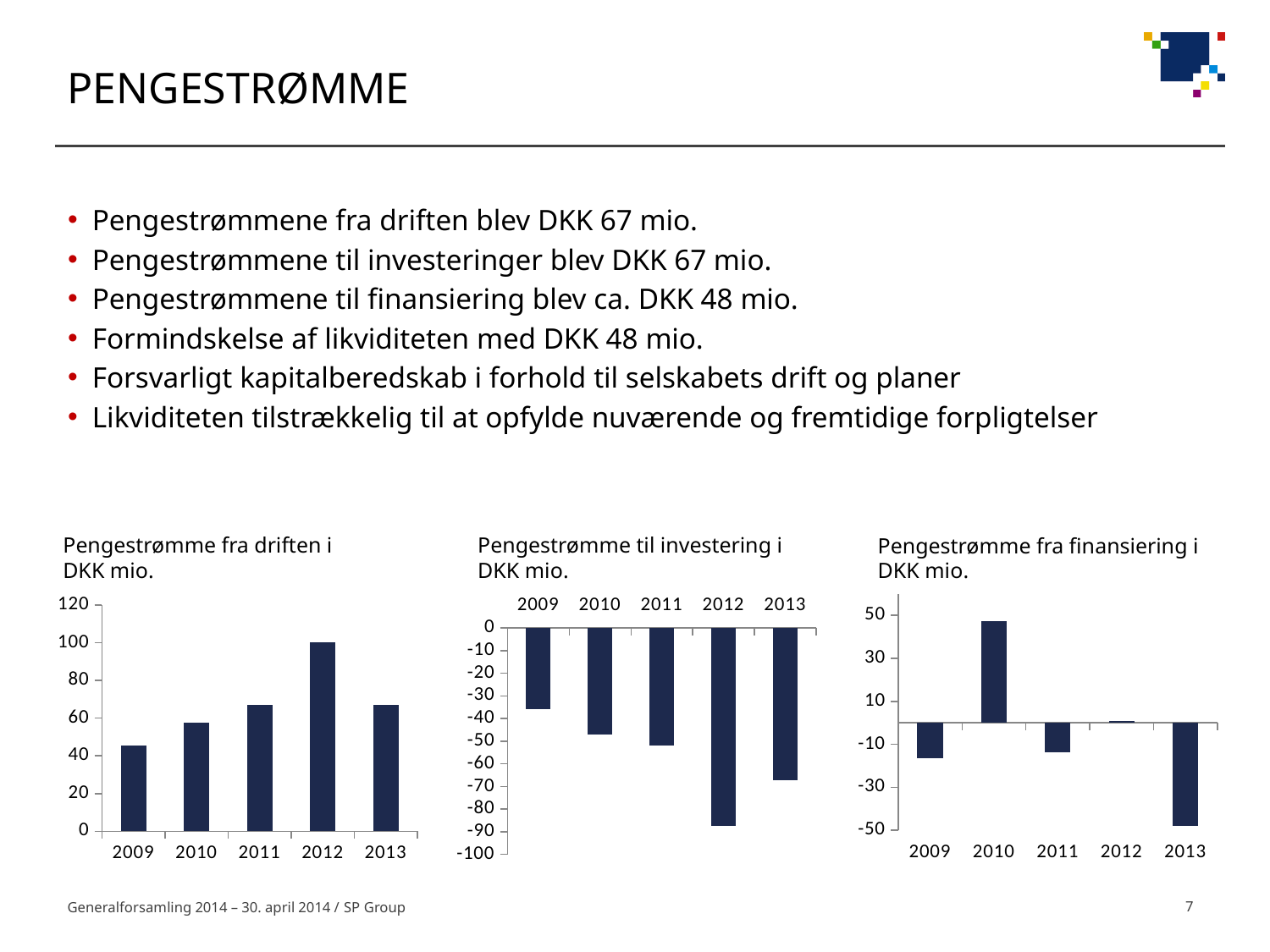
In the 'Pengestrømme fra finansiering i DKK mio.' chart, which year has the highest value? 2010 In the 'Pengestrømme fra finansiering i DKK mio.' chart, is the value for 2013 greater or less than -30? less In the 'Pengestrømme fra finansiering i DKK mio.' chart, which year has the lowest value? 2013 In the 'Pengestrømme til investering i DKK mio.' chart, is the value for 2009 greater or less than -40? greater In the 'Pengestrømme fra driften i DKK mio.' chart, is the value for 2013 greater or less than 60? greater How many years are shown on the 'Pengestrømme fra driften i DKK mio.' chart? 5 What kind of chart is 'Pengestrømme fra driften i DKK mio.'? bar chart In the 'Pengestrømme fra driften i DKK mio.' chart, what is the value for 2012? 100 In the 'Pengestrømme fra driften i DKK mio.' chart, which is larger, 2010 or 2011? 2011 In the 'Pengestrømme fra driften i DKK mio.' chart, which year has the highest value? 2012 In the 'Pengestrømme til investering i DKK mio.' chart, which year has the lowest (most negative) value? 2012 In the 'Pengestrømme fra driften i DKK mio.' chart, which year has the lowest value? 2009